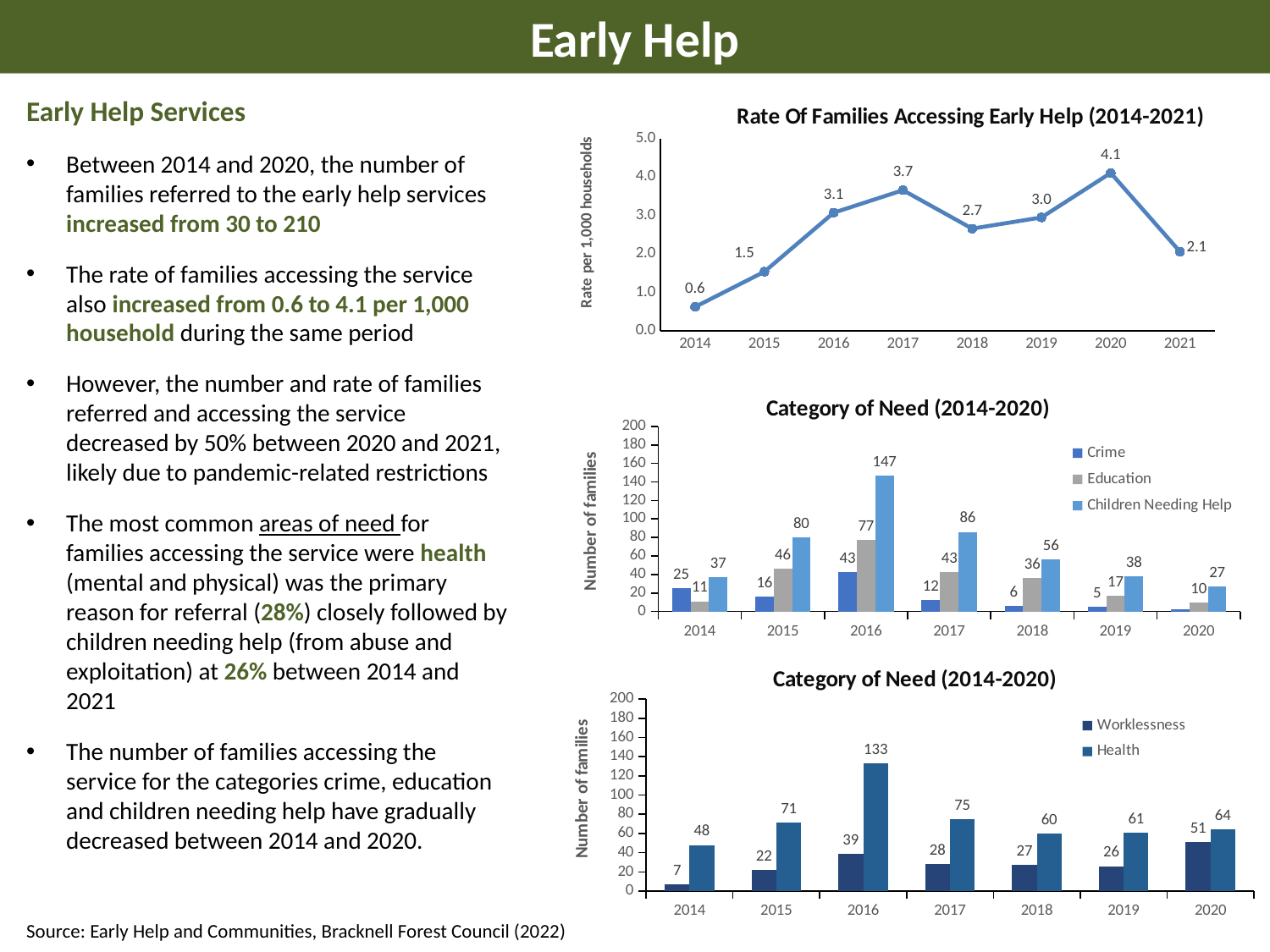
In the bottom bar chart, what is the difference between Health and Worklessness in 2020? 13 In the top line chart, how many years are plotted? 8 In the middle bar chart, is the Crime value for 2014 greater or less than the Education value for 2014? greater In the middle bar chart, how many families were in the Children Needing Help category in 2016? 147 What type of chart is the top chart titled 'Rate Of Families Accessing Early Help (2014-2021)'? line chart In the bottom bar chart, which year had the lowest Worklessness value? 2014 In the middle bar chart, how many series does the legend list? 3 In the top line chart, what was the rate of families accessing Early Help in 2020? 4.1 In the top line chart, what is the difference between the rate in 2020 and the rate in 2021? 2.0 In the bottom bar chart, how many families were in the Health category in 2016? 133 In the middle bar chart, which year had the highest number of families in the Education category? 2016 In the top line chart, which year had the lowest rate of families accessing Early Help? 2014